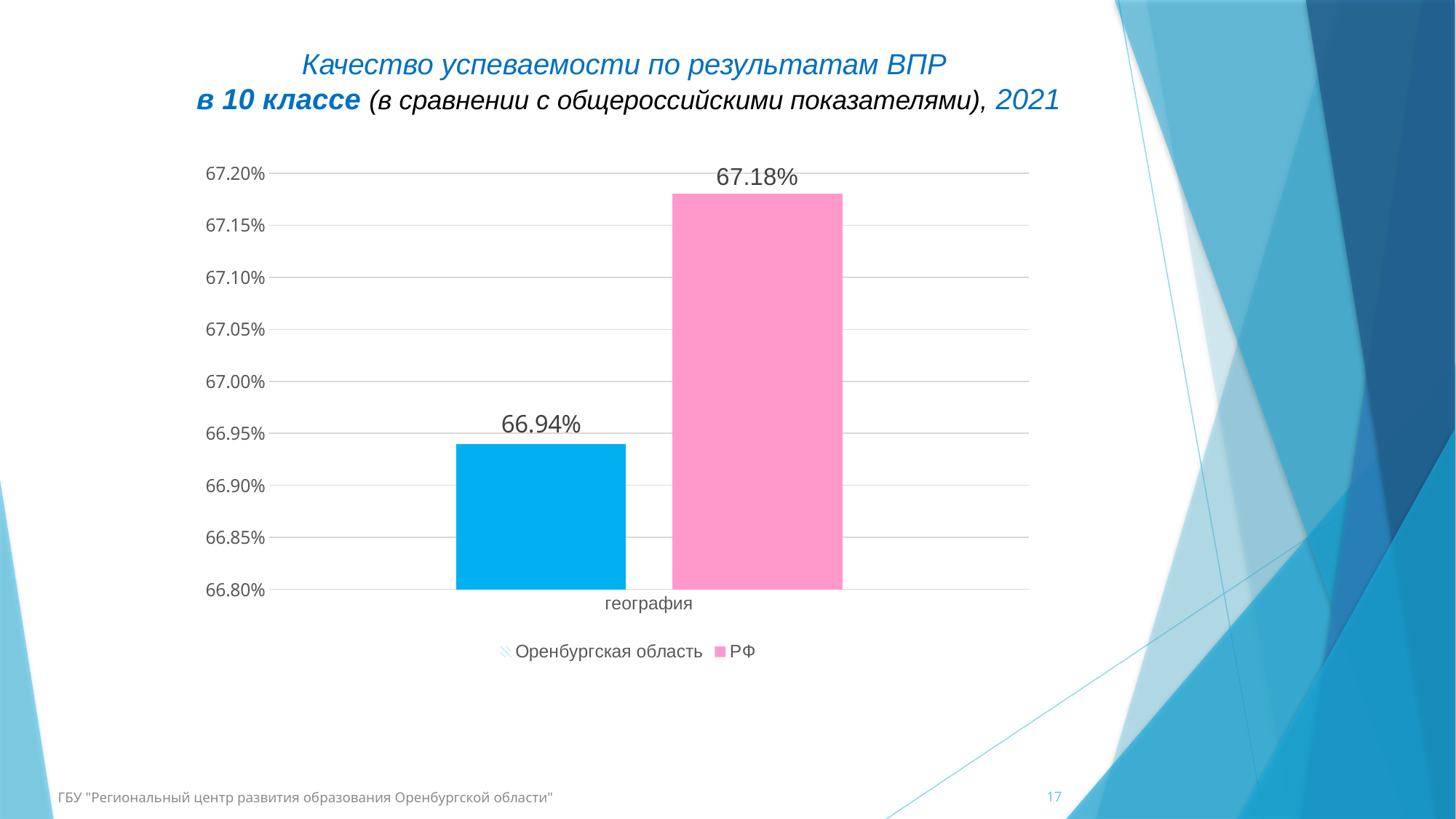
What is the value for РФ in география? 67.18% What colour is the bar for РФ? pink Which series has the lowest value on the chart? Оренбургская область Which series has the higher value for география, Оренбургская область or РФ? РФ Is the value for РФ greater or less than 67.00%? greater Is the value for Оренбургская область greater or less than 67.00%? less What kind of chart is shown on the slide? bar chart How many categories are shown on the x axis? 1 What category label is shown on the x axis? география What is the value for Оренбургская область in география? 66.94% What is the difference between the РФ value and the Оренбургская область value for география? 0.24% How many series does the legend list? 2